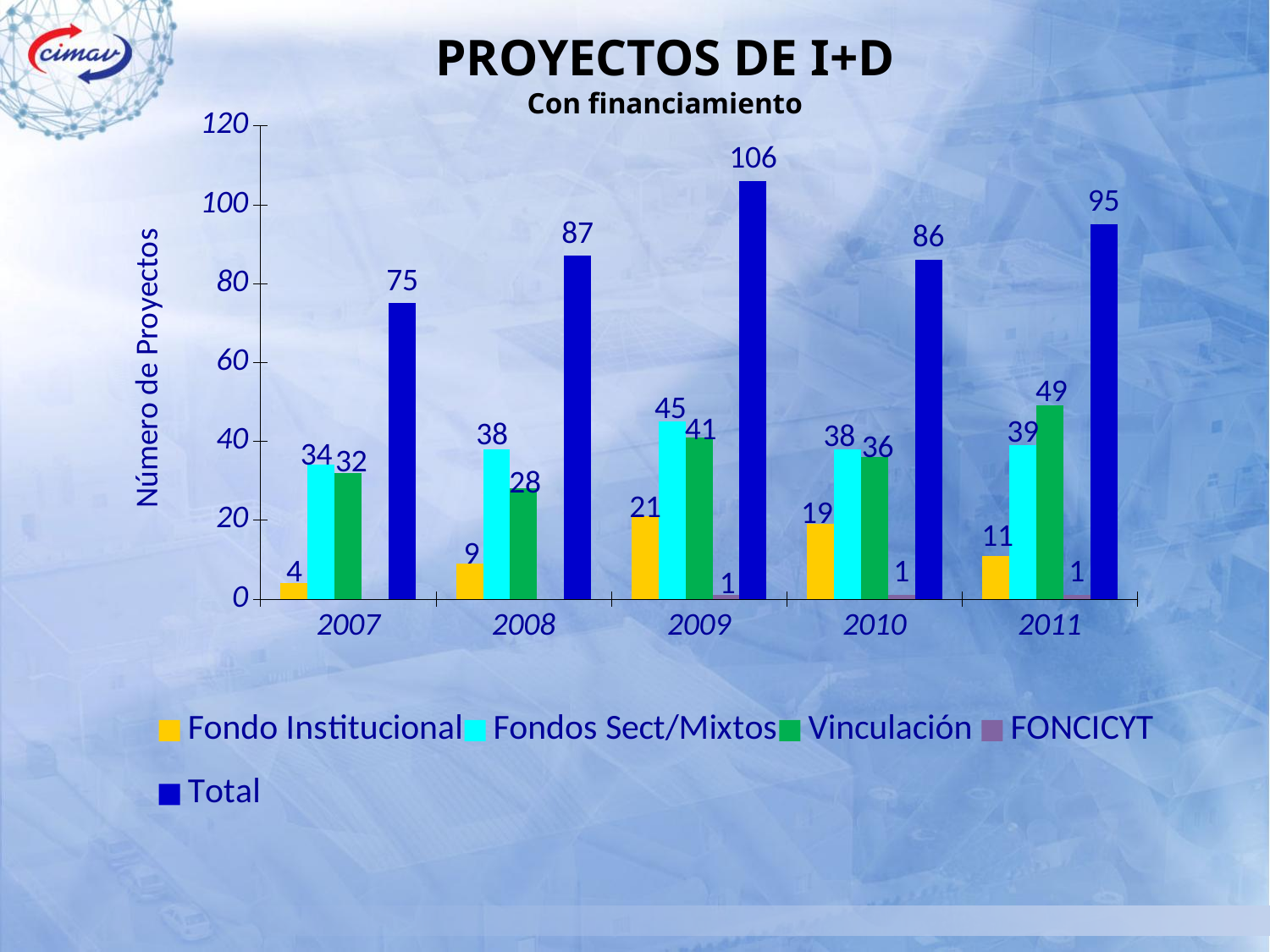
Which year has the lowest Fondo Institucional value? 2007 How many years are shown on the x axis? 5 Which is larger, the Fondos Sect/Mixtos value for 2011 or the Vinculación value for 2011? Vinculación What kind of chart is shown on the slide? Bar chart What is the difference between the Total for 2009 and the Total for 2008? 19 What is the Total value for 2009? 106 What is the Vinculación value for 2011? 49 Which year has the highest Total? 2009 What is the Fondo Institucional value for 2010? 19 What is the y-axis label of the chart? Número de Proyectos What is the Fondos Sect/Mixtos value for 2008? 38 How many series does the legend list? 5